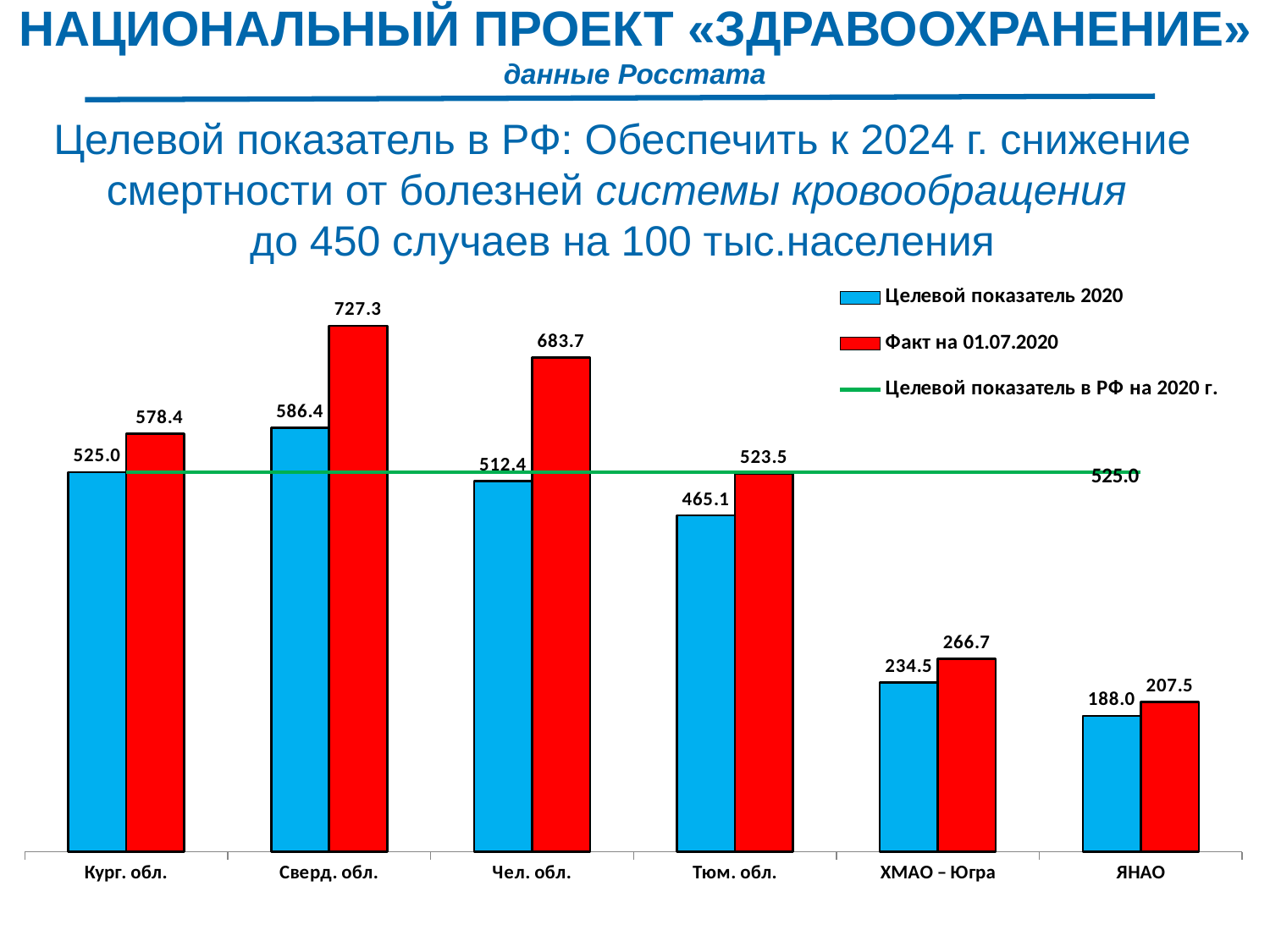
Which is larger for ХМАО – Югра: «Целевой показатель 2020» or «Факт на 01.07.2020»? Факт на 01.07.2020 What is the value of «Факт на 01.07.2020» for Сверд. обл.? 727.3 What is the value of «Целевой показатель 2020» for Тюм. обл.? 465.1 How many regions are shown on the x axis of the chart? 6 Which region has the highest value of «Факт на 01.07.2020»? Сверд. обл. What type of chart is shown on the slide? Combination bar and line chart What value does the green line «Целевой показатель в РФ на 2020 г.» show? 525.0 Which region has the lowest value of «Целевой показатель 2020»? ЯНАО What is the value of «Факт на 01.07.2020» for ЯНАО? 207.5 What colour are the bars for «Факт на 01.07.2020»? Red What is the difference between «Факт на 01.07.2020» and «Целевой показатель 2020» for Чел. обл.? 171.3 How many entries does the chart legend list? 3